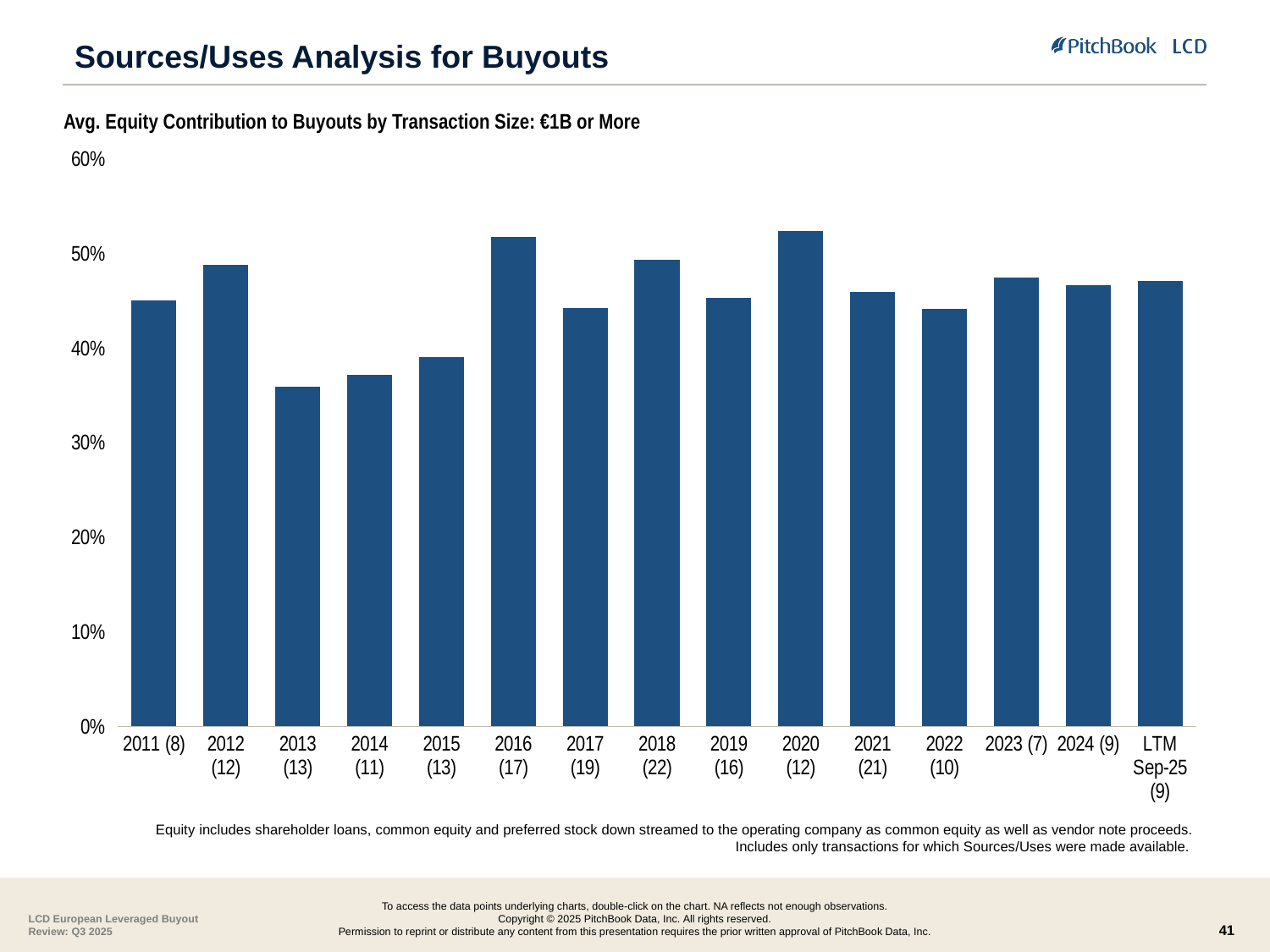
Is the value for 2016 (17) greater or less than 50%? greater Which is larger, the value for 2016 (17) or the value for 2013 (13)? 2016 (17) Is the value for 2020 (12) greater or less than 50%? greater Do the values rise or fall from 2013 (13) to 2016 (17)? rise Which is larger, the value for 2021 (21) or the value for 2022 (10)? 2021 (21) Is the value for 2022 (10) greater or less than 40%? greater Which category has the lowest average equity contribution? 2013 (13) What kind of chart is shown on the slide? bar chart What is the title of the chart? Avg. Equity Contribution to Buyouts by Transaction Size: €1B or More How many bars (categories) are plotted in the chart? 15